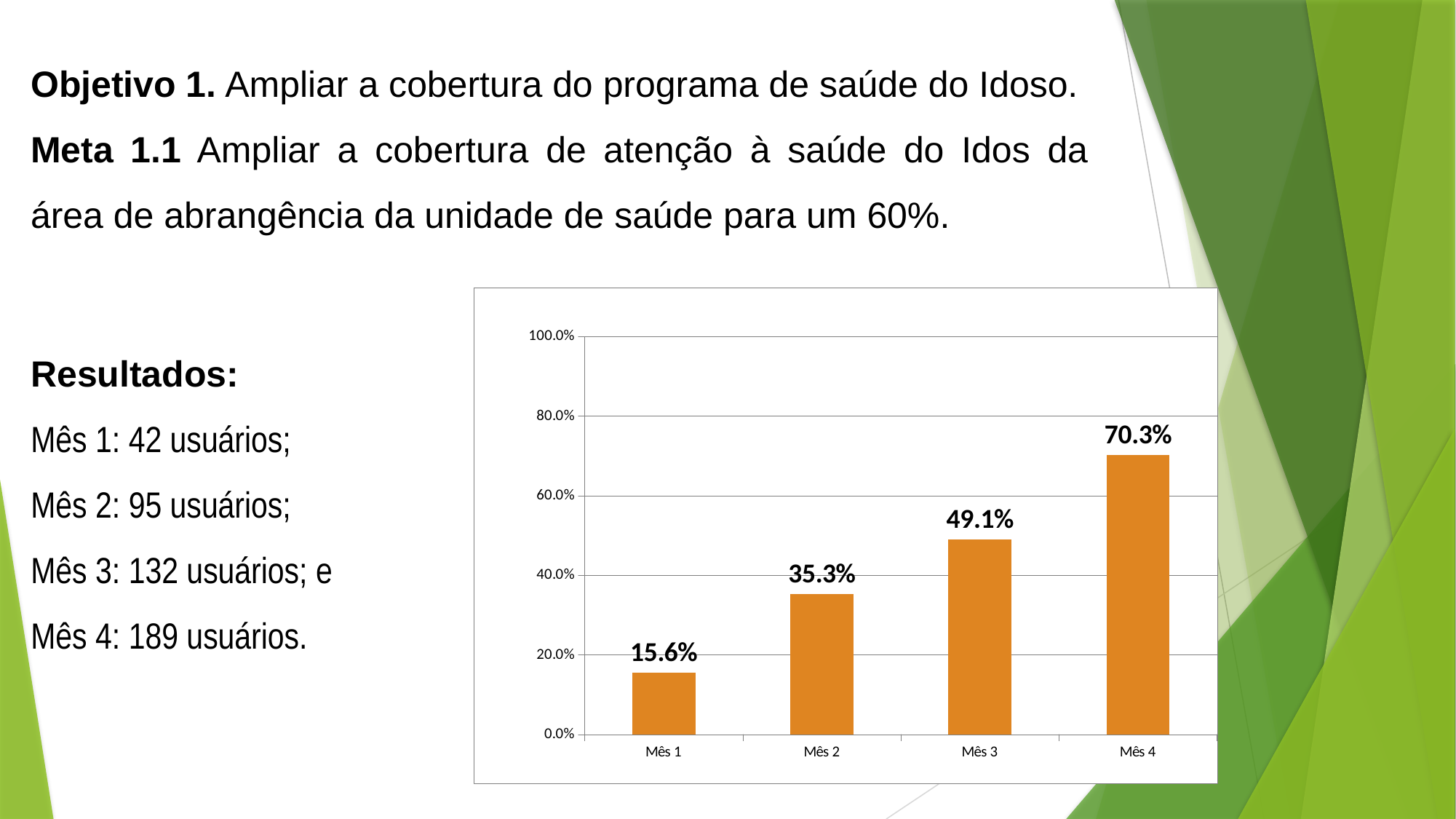
What is the value for Mês 1? 15.6% Is the value for Mês 4 greater or less than 60.0%? greater What kind of chart is shown? bar chart What is the value for Mês 4? 70.3% Which is larger, the value for Mês 2 or the value for Mês 3? Mês 3 Which month has the lowest value? Mês 1 Which month has the highest value? Mês 4 What is the value for Mês 2? 35.3% What is the value for Mês 3? 49.1% How many months are shown on the x axis? 4 What is the difference between the values for Mês 4 and Mês 3? 21.2% What is the difference between the values for Mês 2 and Mês 1? 19.7%